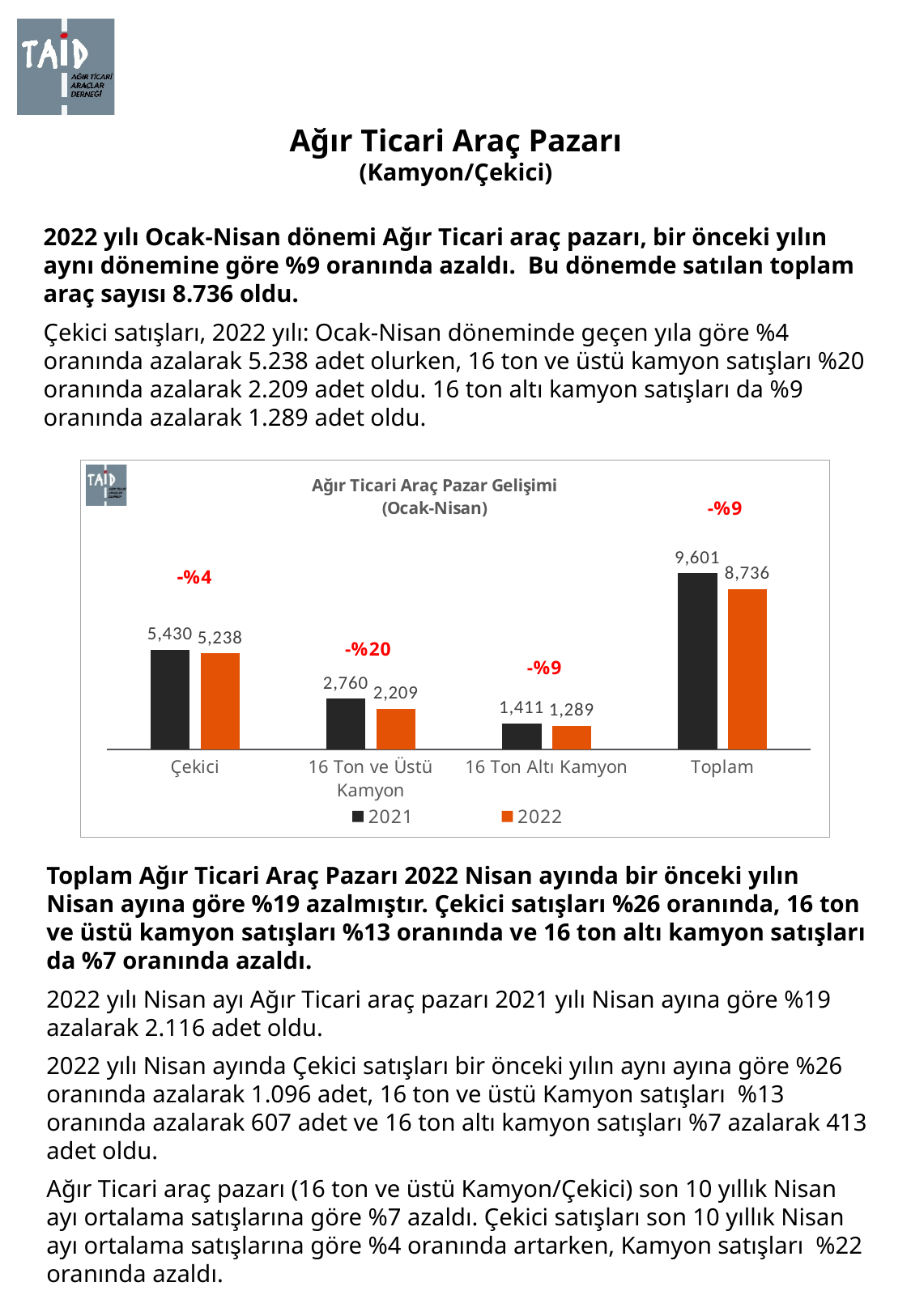
What is the difference between the 2021 and 2022 values for 16 Ton ve Üstü Kamyon? 551 What is the difference between the 2021 and 2022 values for Toplam? 865 Which category has the lowest 2022 value in the chart? 16 Ton Altı Kamyon How many categories are shown on the x axis of the chart? 4 How many series does the chart legend list? 2 What is the 2022 value for Toplam in the chart? 8,736 Which is larger for Çekici: the 2021 value or the 2022 value? 2021 What type of chart is shown on the slide? Bar chart What is the 2021 value for 16 Ton Altı Kamyon in the chart? 1,411 What is the 2022 value for Çekici in the chart? 5,238 Which category has the highest 2021 value in the chart? Toplam What is the 2021 value for 16 Ton ve Üstü Kamyon in the chart? 2,760